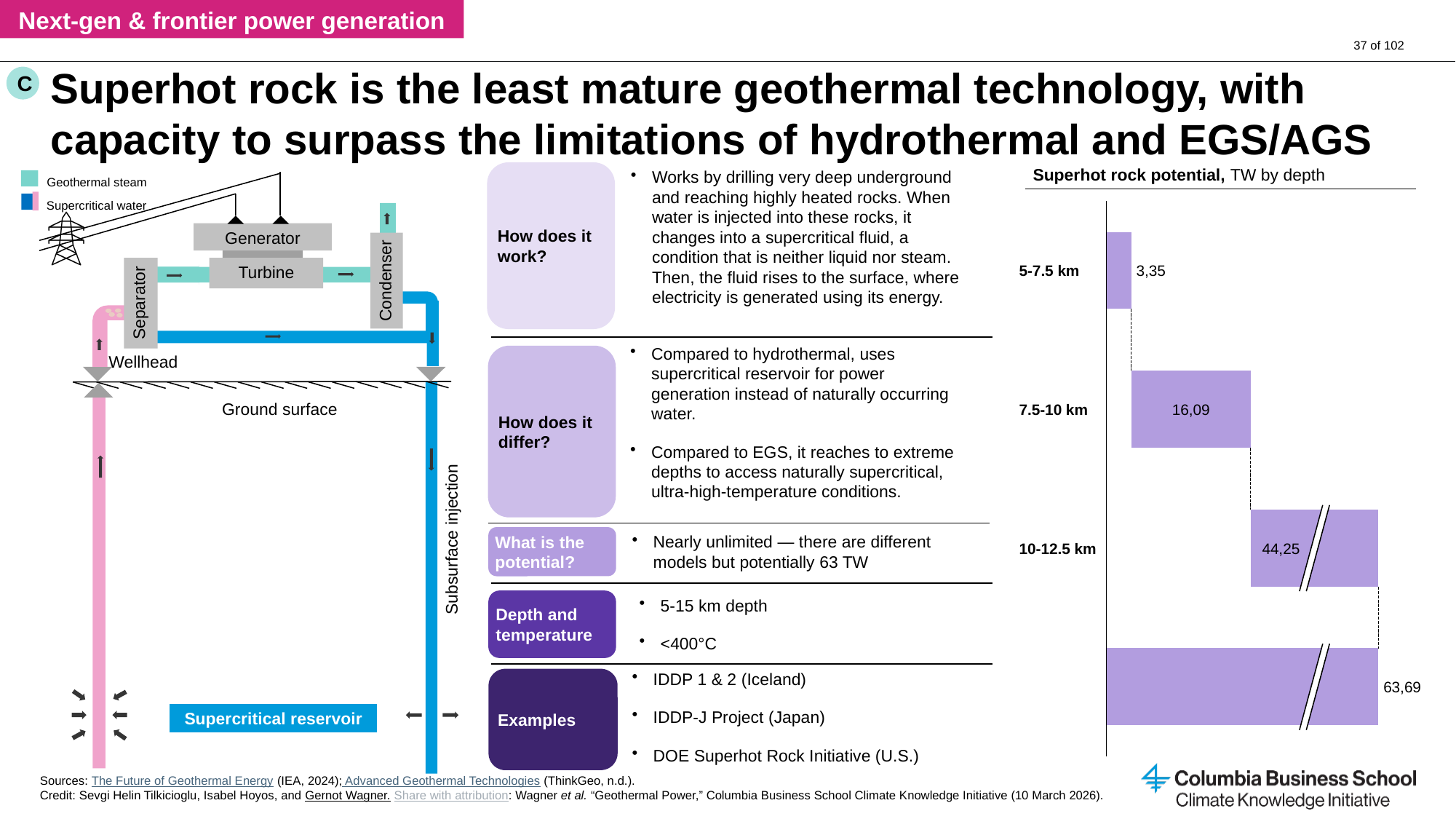
In the 'Superhot rock potential' chart, what is the difference between the 10-12.5 km value and the 7.5-10 km value? 28,16 In the 'Superhot rock potential' chart, what is the value for the 10-12.5 km depth range? 44,25 In the 'Superhot rock potential' chart, what is the value for the 5-7.5 km depth range? 3,35 How many depth ranges are shown in the 'Superhot rock potential' chart? 3 In the 'Superhot rock potential' chart, what is the total potential shown by the final bar? 63,69 What unit is the 'Superhot rock potential' chart measured in, according to its title? TW In the 'Superhot rock potential' chart, which depth range has the highest potential? 10-12.5 km In the 'Superhot rock potential' chart, which depth range has the lowest potential? 5-7.5 km In the 'Superhot rock potential' chart, which is larger: the value for 7.5-10 km or the value for 5-7.5 km? 7.5-10 km In the 'Superhot rock potential' chart, what is the difference between the 7.5-10 km value and the 5-7.5 km value? 12,74 In the 'Superhot rock potential' chart, does the potential rise or fall as depth increases? rise In the 'Superhot rock potential' chart, what is the value for the 7.5-10 km depth range? 16,09